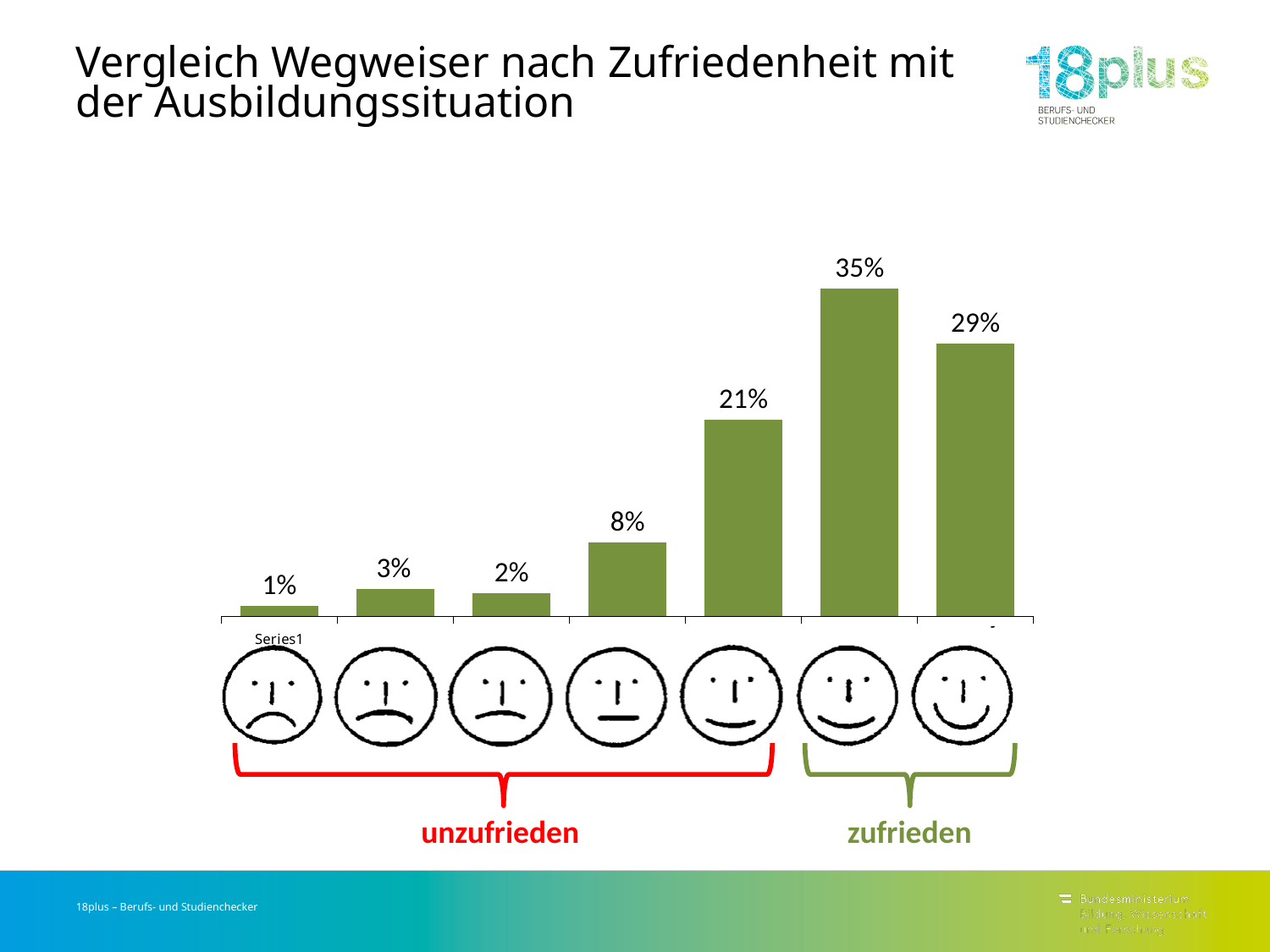
Which bar has the highest value? the sixth bar from the left (35%) What type of chart is shown on the slide? bar chart What is the value of the fourth bar from the left? 8% What is the value of the fifth bar from the left? 21% What is the title of the slide containing the chart? Vergleich Wegweiser nach Zufriedenheit mit der Ausbildungssituation What is the difference between the highest bar (35%) and the rightmost bar (29%)? 6% What is the value of the leftmost bar? 1% Which is larger, the second bar from the left or the third bar from the left? the second bar from the left (3%) What is the total of the two bars grouped under the label 'zufrieden'? 64% How many bars are plotted in the chart? 7 What is the value of the rightmost bar? 29% Which bar has the lowest value? the leftmost bar (1%)